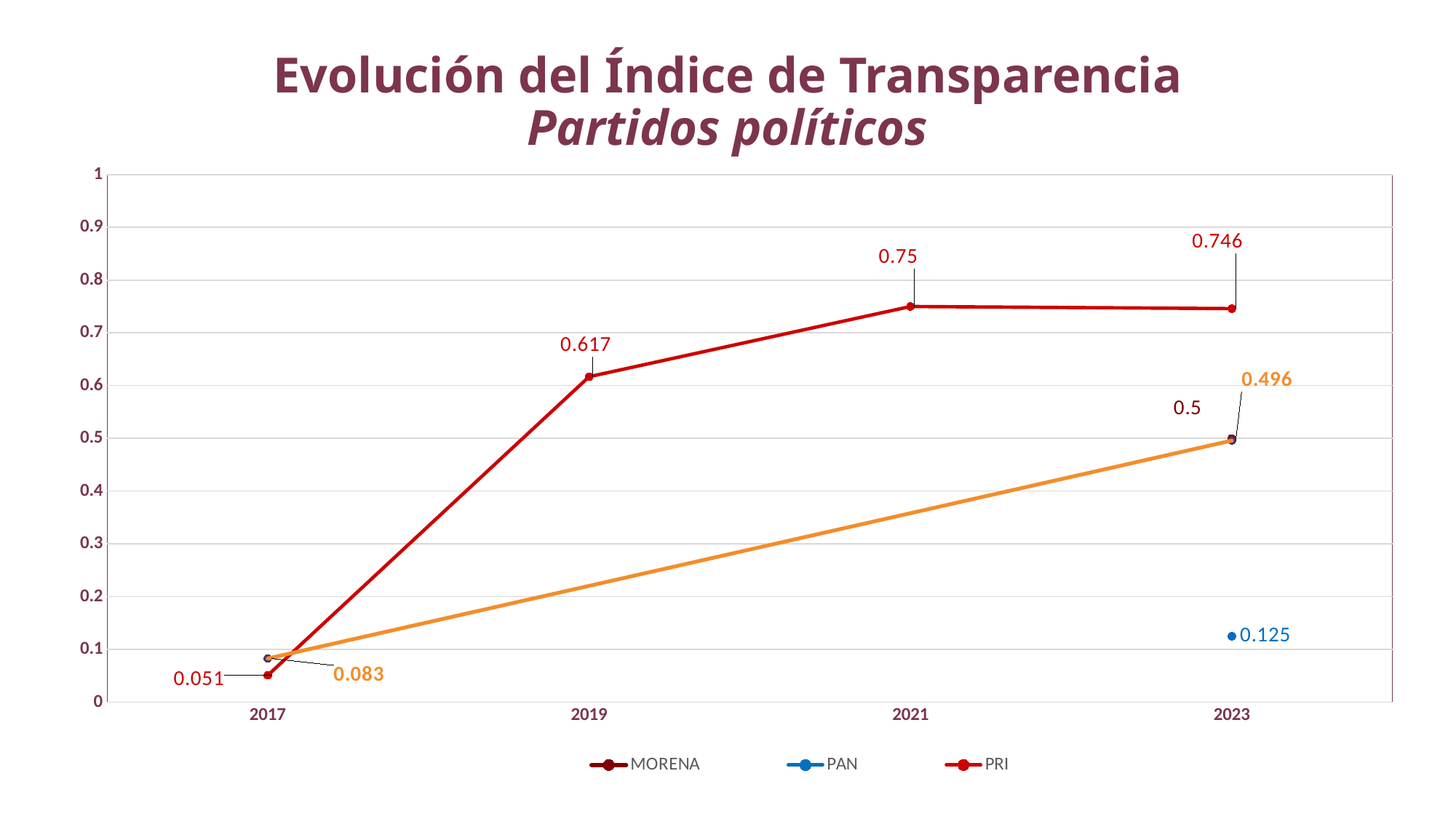
How many years are shown on the x axis? 4 What is the PRI value in 2017? 0.051 What is the difference between the PRI values in 2021 and 2019? 0.133 What is the PRI value in 2023? 0.746 Which party has the highest value in 2023? PRI Does the PRI value rise or fall from 2017 to 2021? rise What is the PRI value in 2019? 0.617 How many series does the legend list? 3 What is the MORENA value in 2023? 0.5 What is the PAN value in 2023? 0.125 What kind of chart is shown on the slide? line chart What is the PRI value in 2021? 0.75